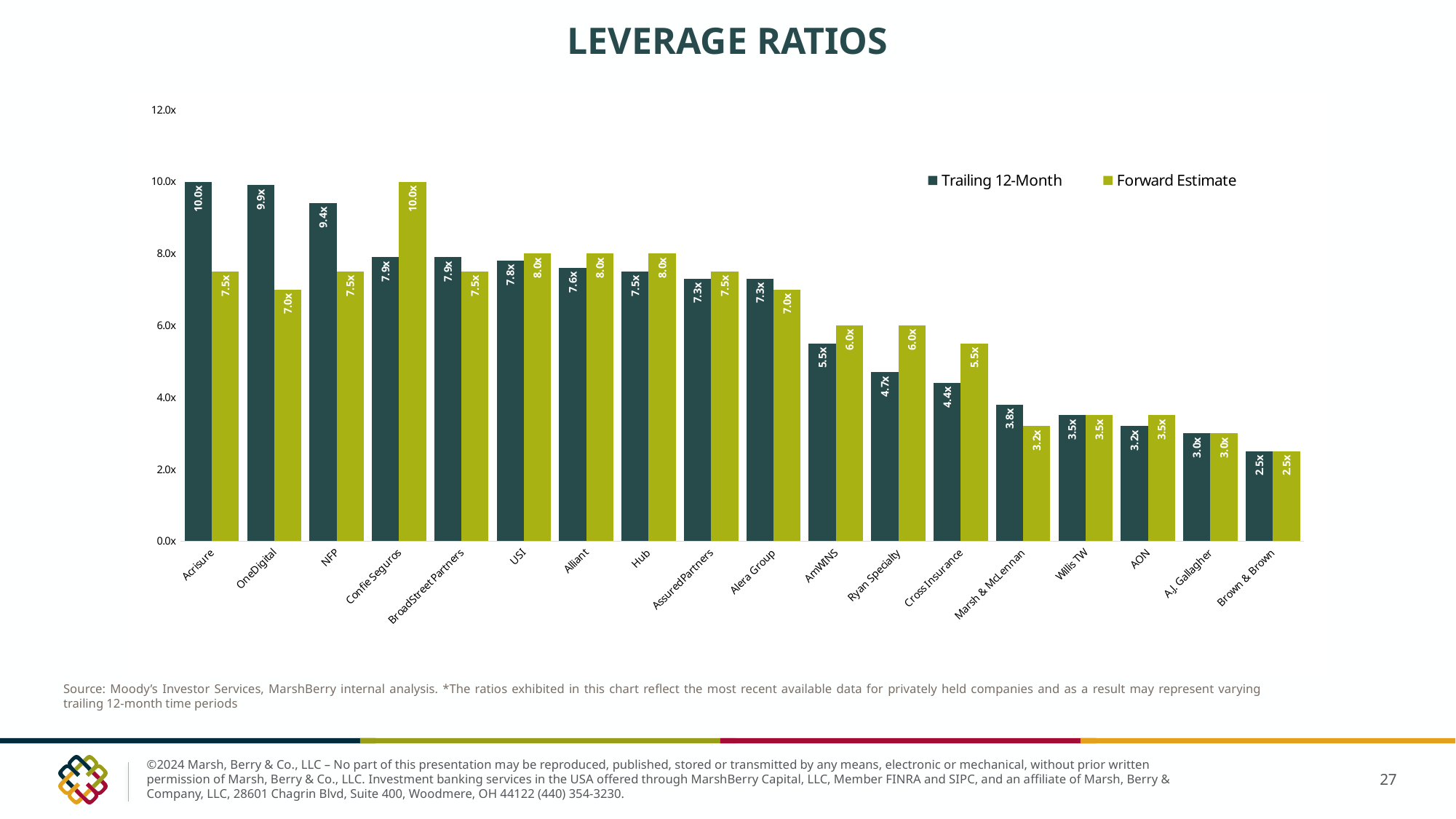
What is the title of the chart? LEVERAGE RATIOS What is the Forward Estimate leverage ratio for Confie Seguros? 10.0x What kind of chart is shown on the slide? Bar chart Which company has the highest Trailing 12-Month leverage ratio? Acrisure Which company has the lowest Forward Estimate leverage ratio? Brown & Brown How many companies are shown on the x axis of the chart? 18 Which is larger for Cross Insurance, the Trailing 12-Month or the Forward Estimate leverage ratio? Forward Estimate What is the difference between the Trailing 12-Month and Forward Estimate leverage ratios for OneDigital? 2.9x What is the Trailing 12-Month leverage ratio for Ryan Specialty? 4.7x What is the Forward Estimate leverage ratio for Marsh & McLennan? 3.2x What is the Trailing 12-Month leverage ratio for Acrisure? 10.0x How many series does the legend list? 2